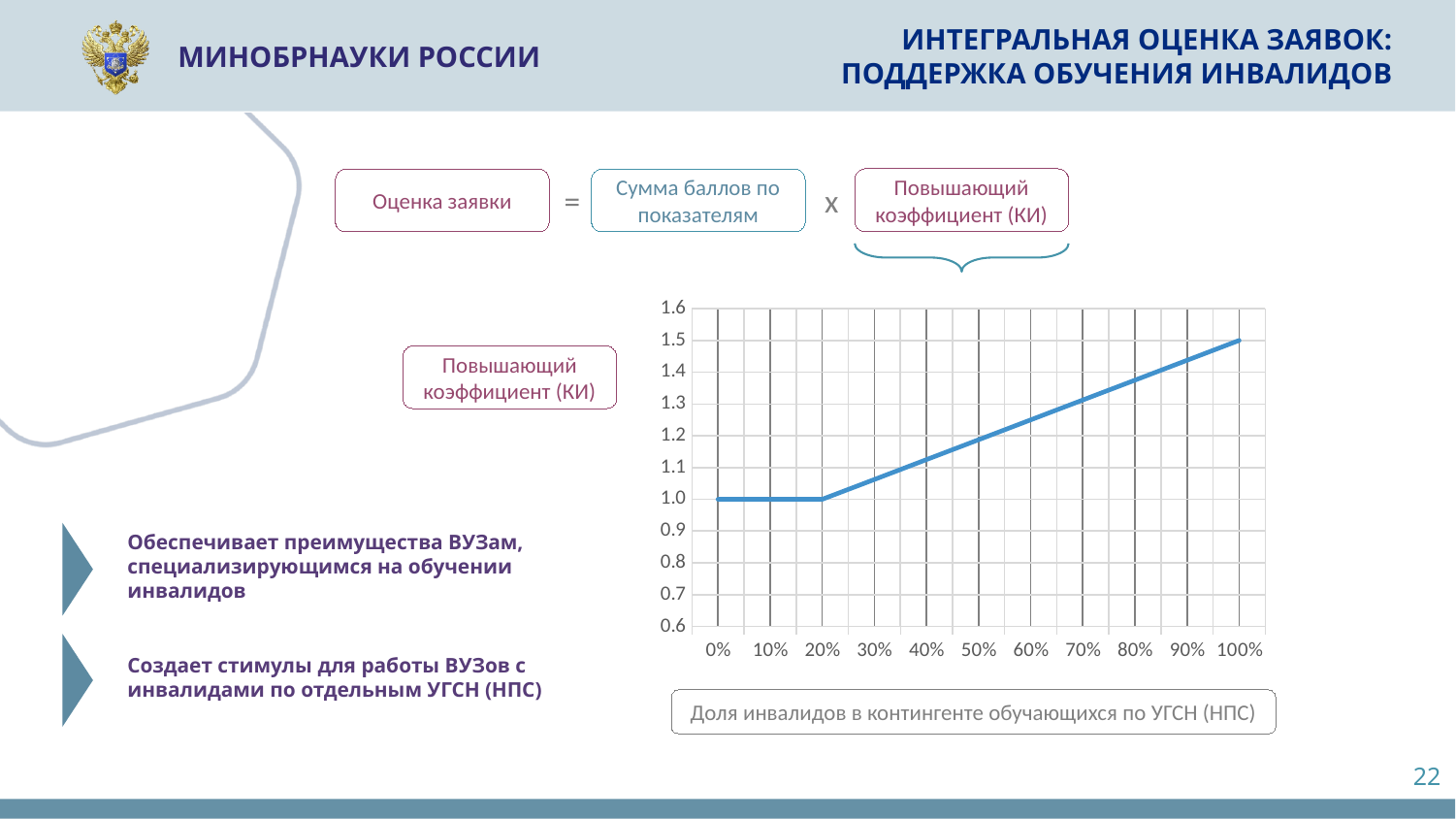
Is the value of the coefficient at 60% greater or less than 1.1? greater At which share on the x axis does the coefficient reach its highest value? 100% Is the value of the coefficient at 40% greater or less than 1.2? less Does the coefficient rise or fall as the share on the x axis increases from 20% to 100%? rises Is the value of the coefficient at 80% greater or less than 1.3? greater What kind of chart is shown on the slide? line chart What is the value of the coefficient (КИ) at a share of 20%? 1.0 What is the difference between the coefficient at 100% and the coefficient at 0%? 0.5 Which is larger: the coefficient at 100% or the coefficient at 20%? 100% How many share values are marked on the x axis of the chart? 11 What is the value of the coefficient (КИ) at a share of 100%? 1.5 What is the value of the coefficient (КИ) at a share of 0%? 1.0